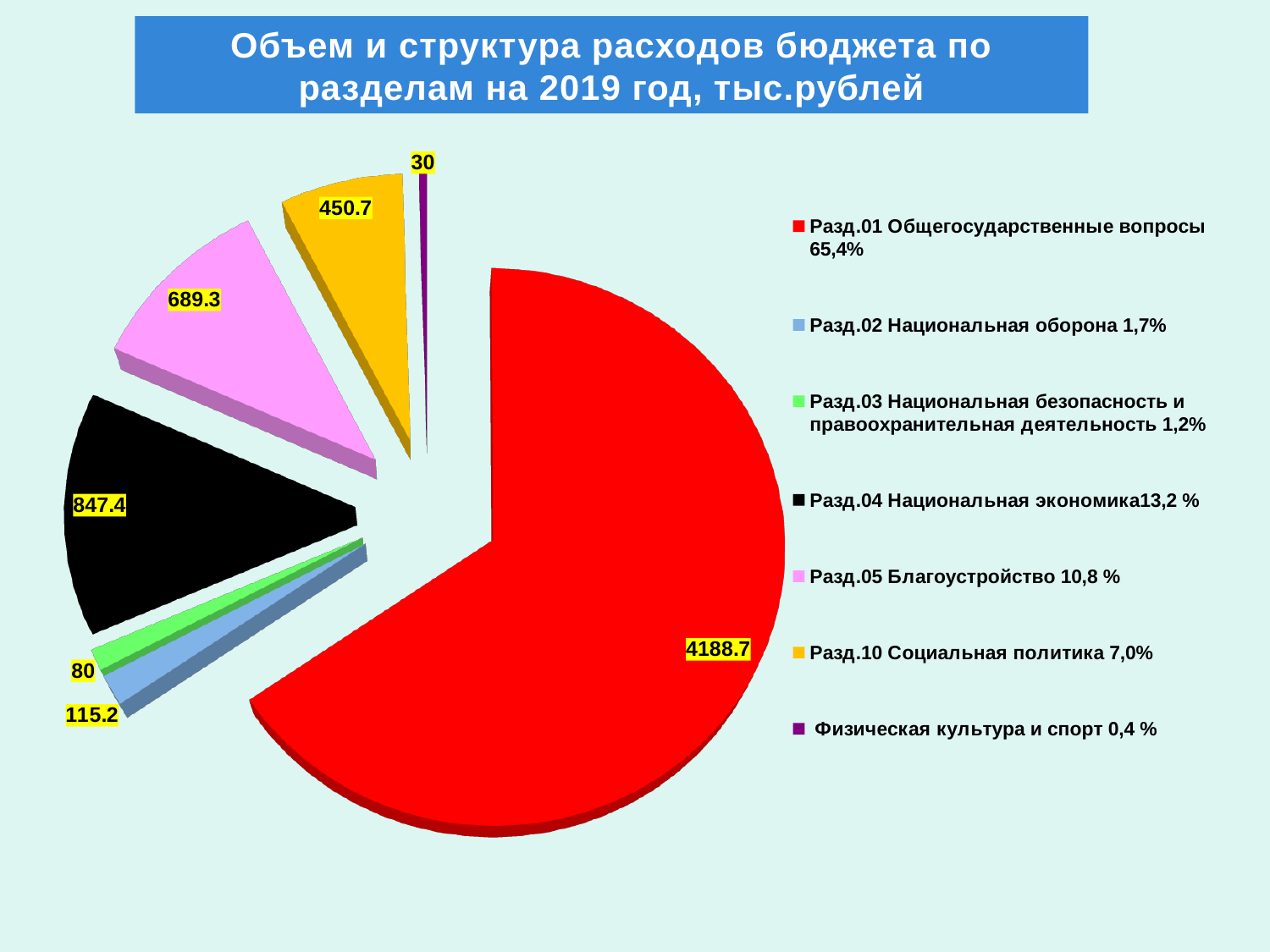
What share of the pie does Разд.05 Благоустройство represent, according to the legend? 10,8 % Which is larger: the value for Разд.02 Национальная оборона or Разд.03 Национальная безопасность и правоохранительная деятельность? Разд.02 Национальная оборона Which section has the largest slice of the pie? Разд.01 Общегосударственные вопросы What colour is the slice for Разд.10 Социальная политика? yellow What is the difference between the values for Разд.04 Национальная экономика and Разд.05 Благоустройство? 158.1 What is the value for Разд.05 Благоустройство? 689.3 What is the value for Разд.01 Общегосударственные вопросы? 4188.7 How many slices does the pie chart have? 7 What kind of chart is shown on the slide? pie chart Which section has the smallest slice of the pie? Физическая культура и спорт What is the value for Разд.04 Национальная экономика? 847.4 What is the value for Разд.10 Социальная политика? 450.7